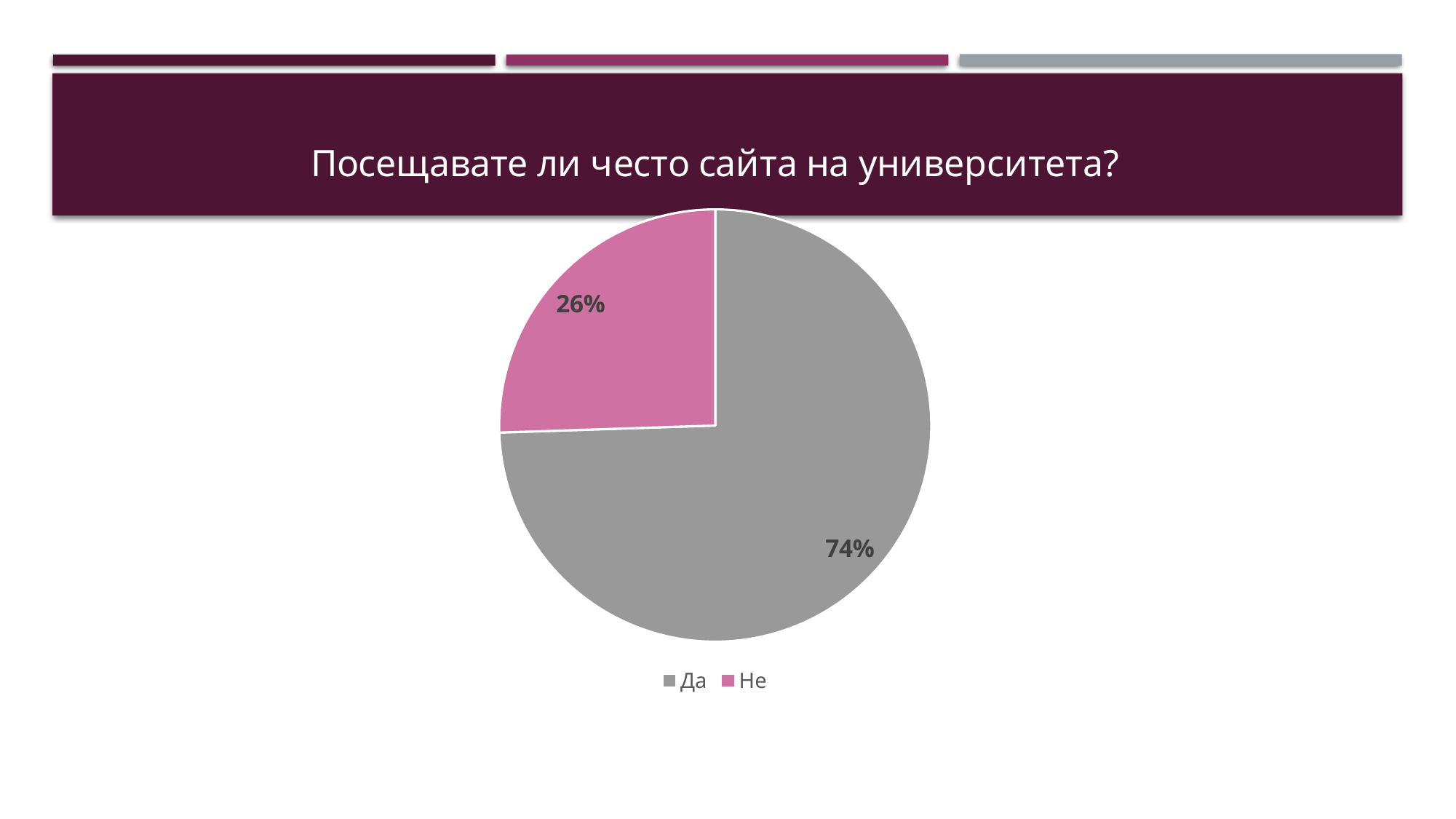
Which is larger, the "Да" slice or the "Не" slice? Да What kind of chart is shown on the slide? pie chart What share of the pie does the "Не" slice represent? 26% How many entries does the legend list? 2 How many slices does the pie chart have? 2 What colour is the "Не" slice in the pie chart? pink Which slice is the largest in the pie chart? Да What share of the pie does the "Да" slice represent? 74% What is the title shown above the chart? Посещавате ли често сайта на университета? What is the difference in percentage points between the "Да" and "Не" slices? 48 Which slice is the smallest in the pie chart? Не